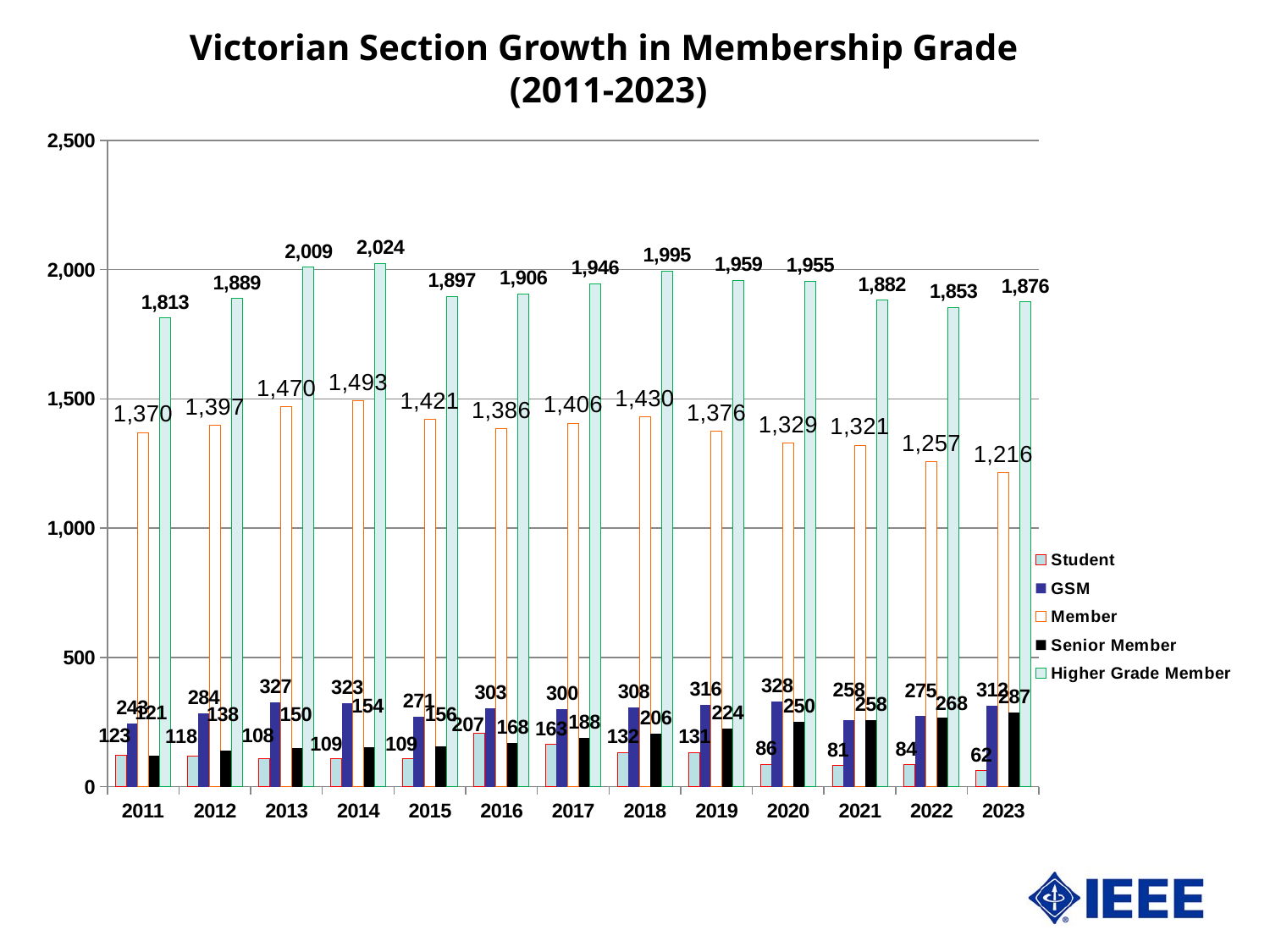
What is the Senior Member value for 2023? 287 What is the Member value for 2014? 1,493 Which year has the larger Student value, 2015 or 2016? 2016 In which year is the Member value lowest? 2023 How many series does the legend list? 5 In which year is the Higher Grade Member value highest? 2014 What kind of chart is shown on the slide? bar chart What colour represents Senior Member in the legend? black Is the Member value for 2022 greater or less than 1,500? less Does the Senior Member value rise or fall from 2011 to 2023? rise How many years are shown on the x axis? 13 What is the difference between the Higher Grade Member values for 2014 and 2011? 211